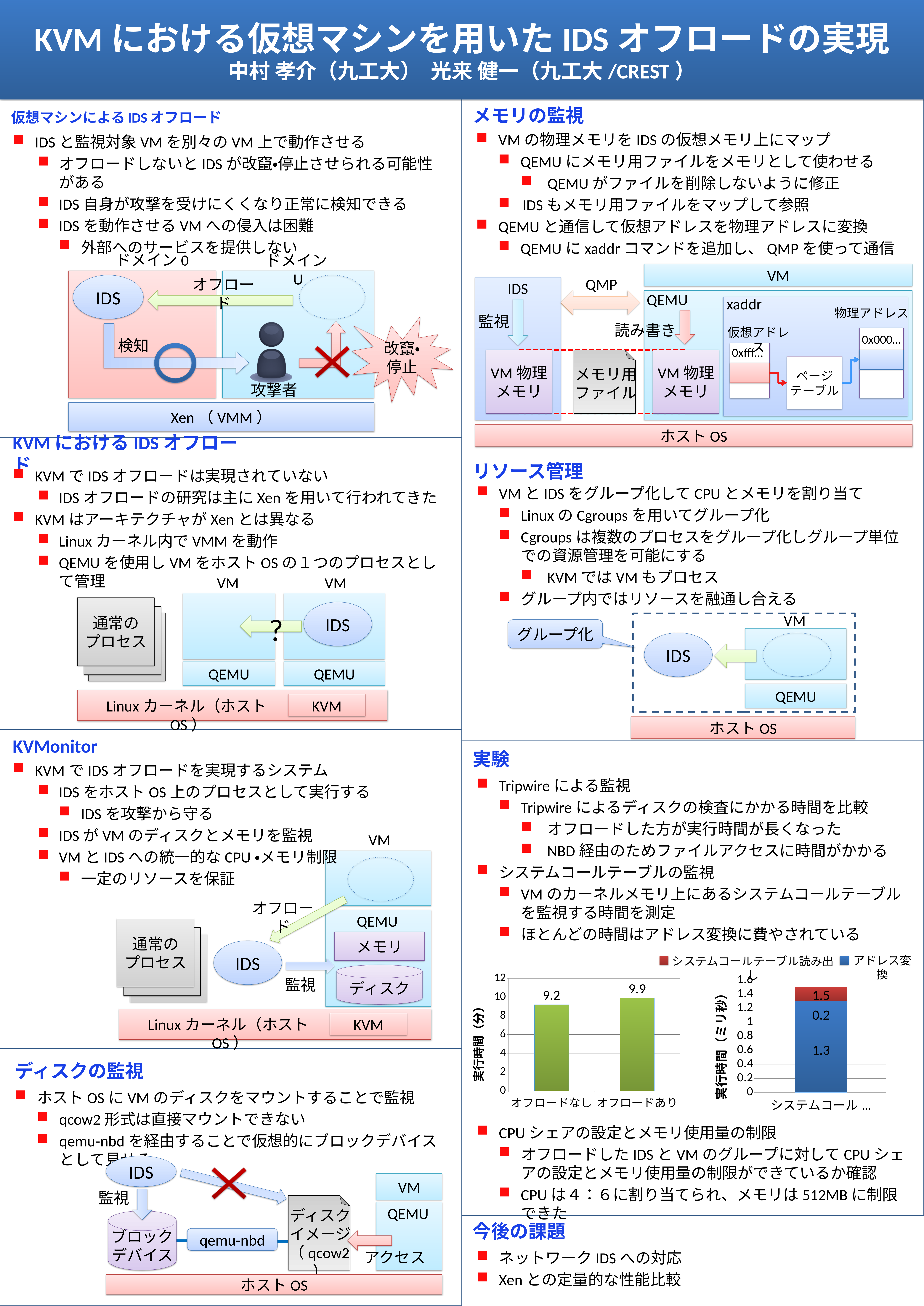
In the right stacked bar chart, what is the value of the システムコールテーブル読み出し segment? 0.2 In the left bar chart, what is the difference between オフロードあり and オフロードなし? 0.7 In the left bar chart, what is the value for オフロードなし? 9.2 In the left bar chart, how many categories are shown on the x axis? 2 In the right stacked bar chart, how many series does the legend list? 2 In the left bar chart, what is the label of the y axis? 実行時間（分） In the right stacked bar chart, what is the total of the stacked bar? 1.5 In the right stacked bar chart, what is the value of the アドレス変換 segment? 1.3 In the left bar chart, which category has the higher execution time? オフロードあり In the right stacked bar chart, which segment is larger, アドレス変換 or システムコールテーブル読み出し? アドレス変換 What type of chart is the left chart? bar chart In the left bar chart, what is the value for オフロードあり? 9.9